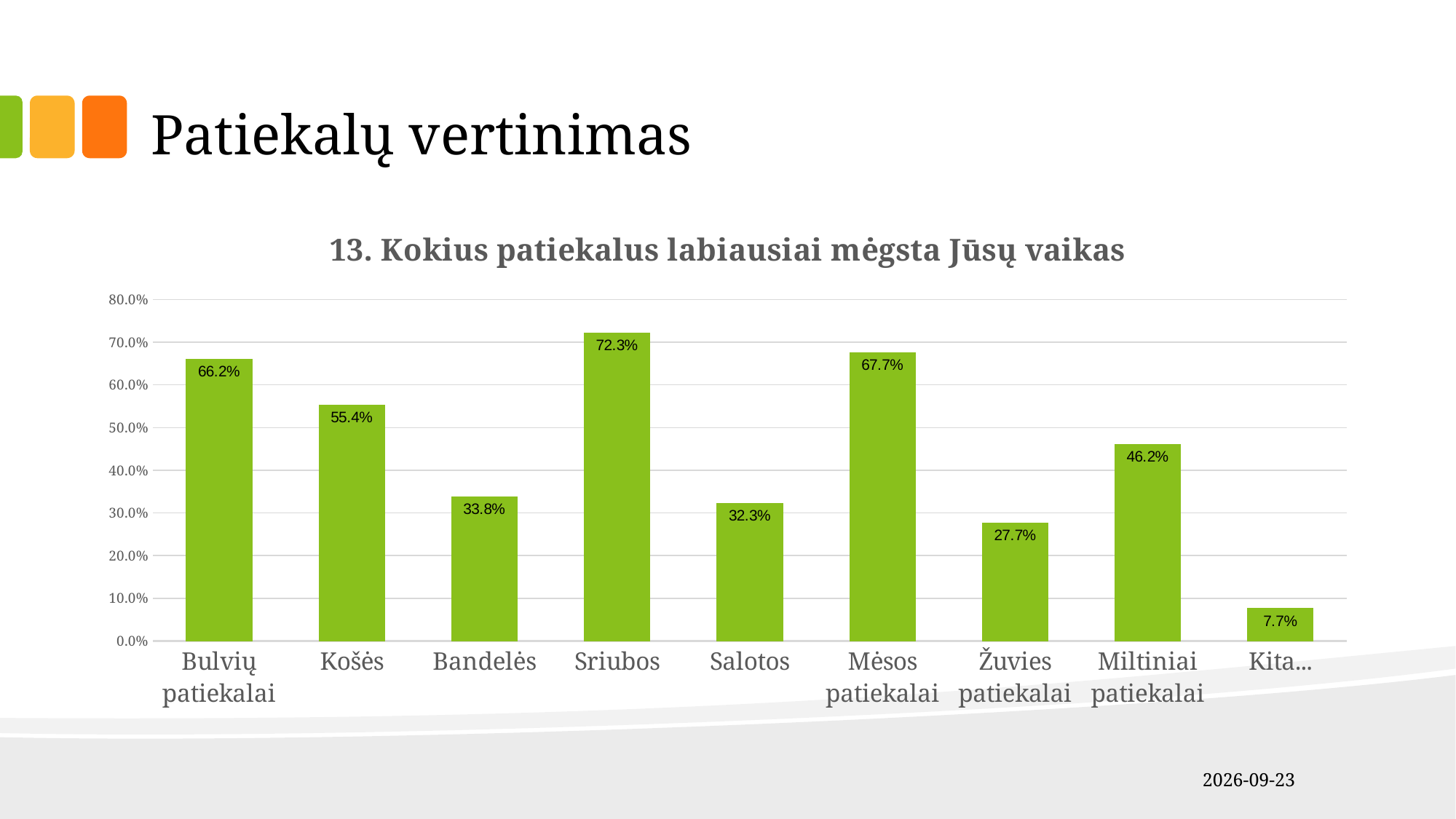
What is the difference between the values for Sriubos and Mėsos patiekalai? 4.6% What is the title of the chart? 13. Kokius patiekalus labiausiai mėgsta Jūsų vaikas What is the value for Bulvių patiekalai? 66.2% What kind of chart is shown on the slide? Bar chart Which category has the lowest value? Kita… Which category has the highest value? Sriubos What is the value for Žuvies patiekalai? 27.7% What colour are the bars in the chart? Green Which is larger, the value for Košės or the value for Miltiniai patiekalai? Košės What is the value for Sriubos? 72.3% How many categories are shown on the x axis? 9 Is the value for Bandelės greater or less than 30.0%? greater